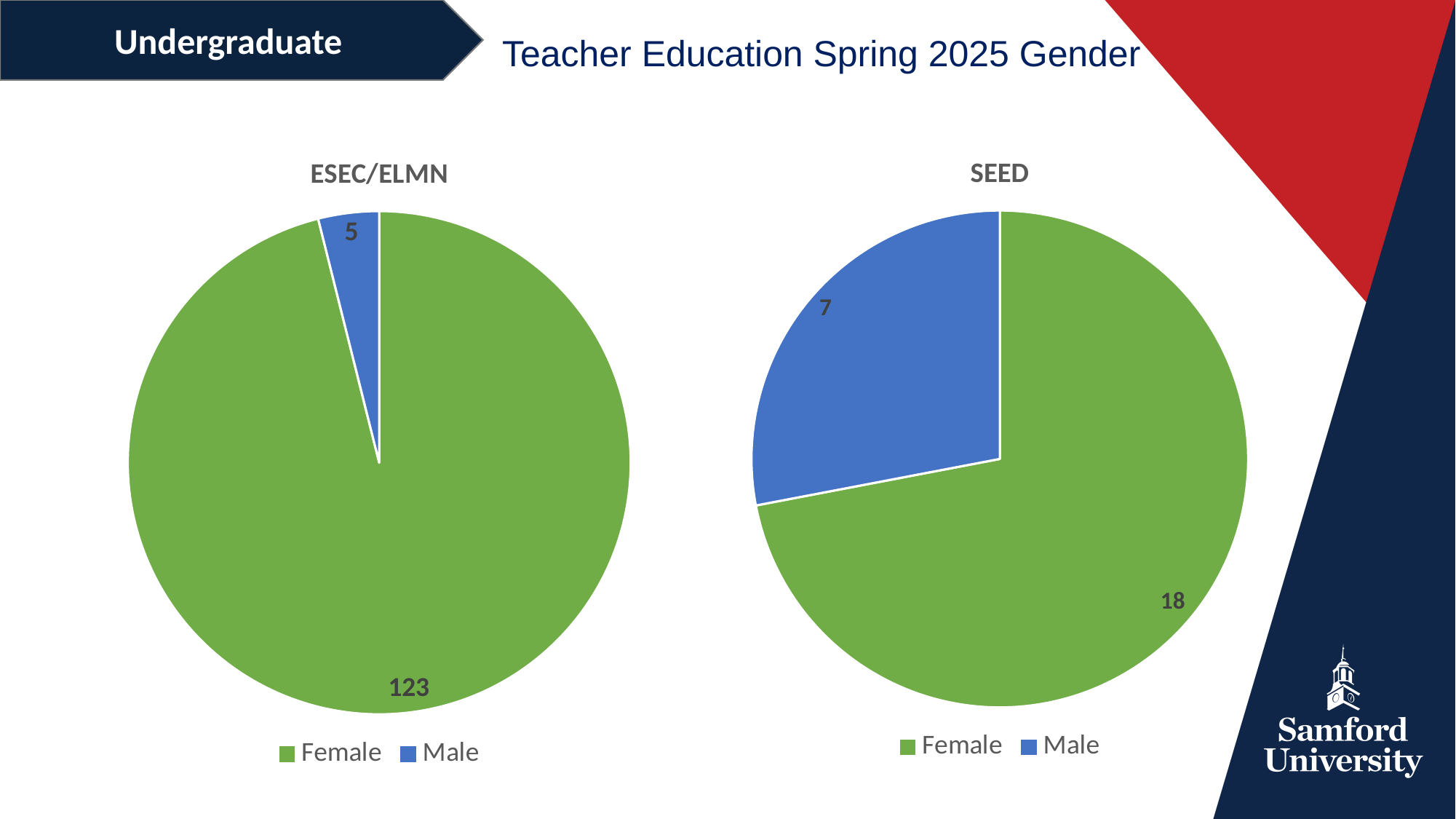
What kind of chart is the SEED chart? Pie chart In the ESEC/ELMN chart, what is the difference between the Female and Male values? 118 In the SEED chart, what is the value for Female? 18 In the ESEC/ELMN chart, which category has the largest slice? Female In the SEED chart, what is the total of all slices? 25 In the ESEC/ELMN chart, what is the value for Male? 5 In the SEED chart, what is the value for Male? 7 In the SEED chart, what is the difference between the Female and Male values? 11 How many entries does the legend of the ESEC/ELMN chart list? 2 In the ESEC/ELMN chart, what share of the pie does the Male slice represent, to the nearest whole percent? 4% In the ESEC/ELMN chart, what is the value for Female? 123 In the SEED chart, which category has the smallest slice? Male